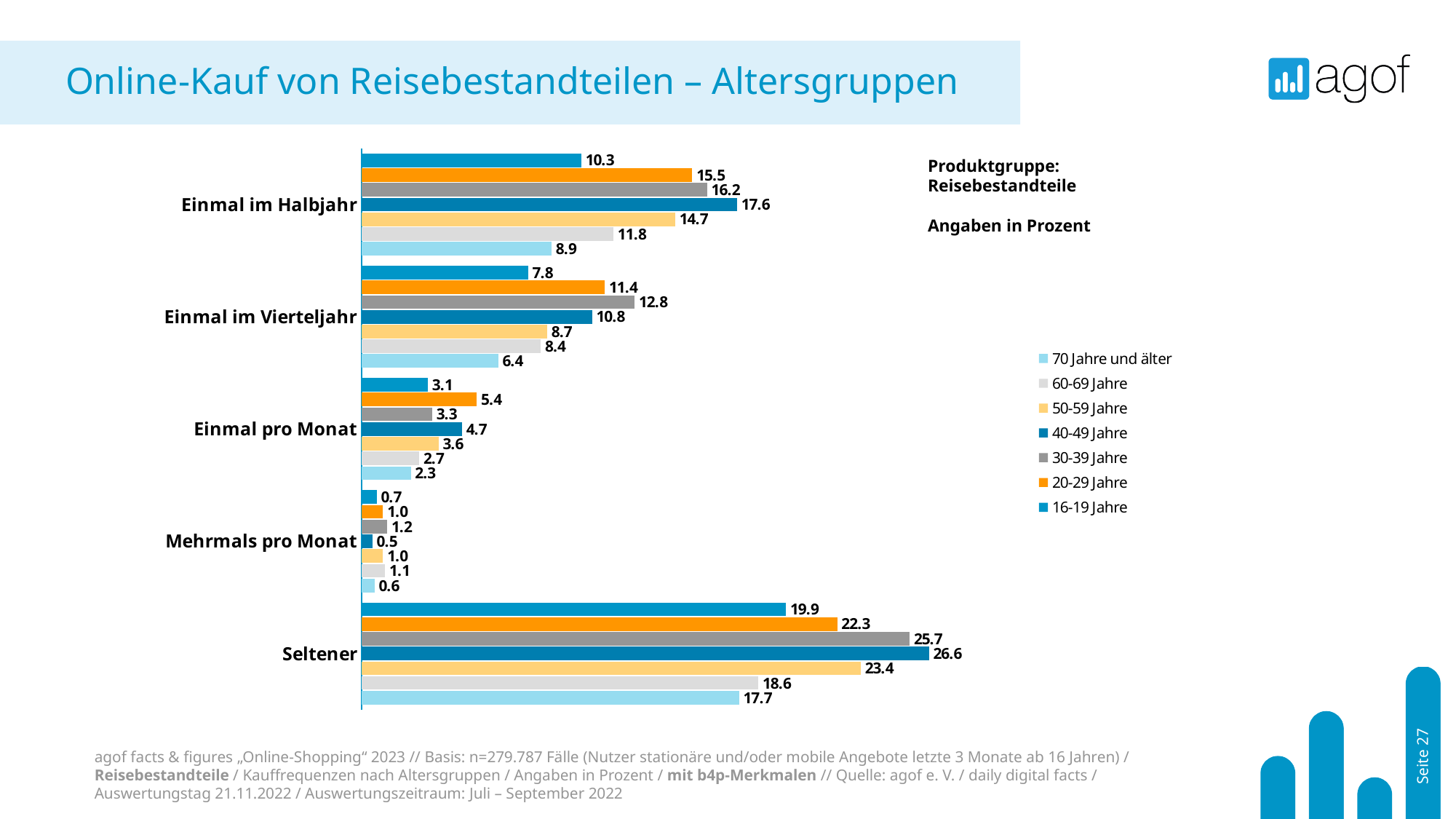
What is the value for the 30-39 Jahre group in the category 'Mehrmals pro Monat'? 1.2 How many age groups does the legend list? 7 What is the title of the chart on the slide? Online-Kauf von Reisebestandteilen – Altersgruppen Which age group has the highest value in the category 'Seltener'? 40-49 Jahre What is the value for the 20-29 Jahre group in the category 'Einmal pro Monat'? 5.4 In the category 'Einmal im Halbjahr', which is larger: the value for 20-29 Jahre or for 50-59 Jahre? 20-29 Jahre What is the value for the 70 Jahre und älter group in the category 'Seltener'? 17.7 What kind of chart is shown on the slide? bar chart How many purchase-frequency categories are shown on the chart? 5 What is the difference between the 30-39 Jahre and 16-19 Jahre values in the category 'Einmal im Vierteljahr'? 5.0 What is the value for the 40-49 Jahre group in the category 'Einmal im Halbjahr'? 17.6 Which age group has the lowest value in the category 'Einmal im Vierteljahr'? 70 Jahre und älter